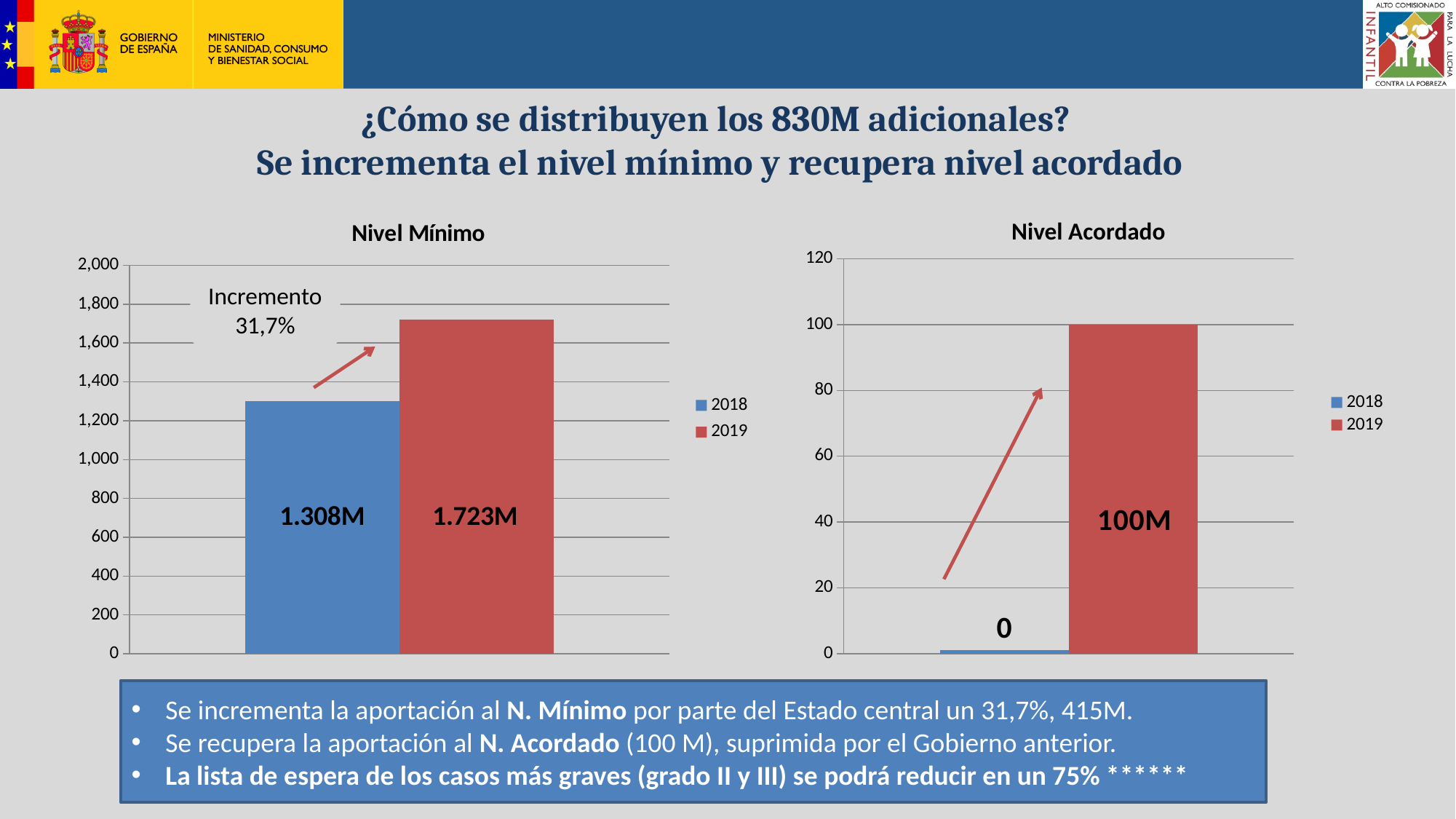
In the Nivel Mínimo chart, what is the value for 2018? 1.308M What percentage increase is annotated on the Nivel Mínimo chart? 31,7% In the Nivel Mínimo chart, is the value for 2018 greater or less than 1,200? greater In the Nivel Mínimo chart, what is the value for 2019? 1.723M What kind of chart is the Nivel Mínimo chart? Bar chart In the Nivel Acordado chart, what is the value for 2019? 100M In the Nivel Mínimo chart, do the values rise or fall from 2018 to 2019? Rise How many series does the legend of the Nivel Acordado chart list? 2 In the Nivel Acordado chart, which year has the lower value? 2018 In the Nivel Mínimo chart, which year has the higher value? 2019 In the Nivel Mínimo chart, is the value for 2019 greater or less than 1,800? less In the Nivel Acordado chart, what is the value for 2018? 0